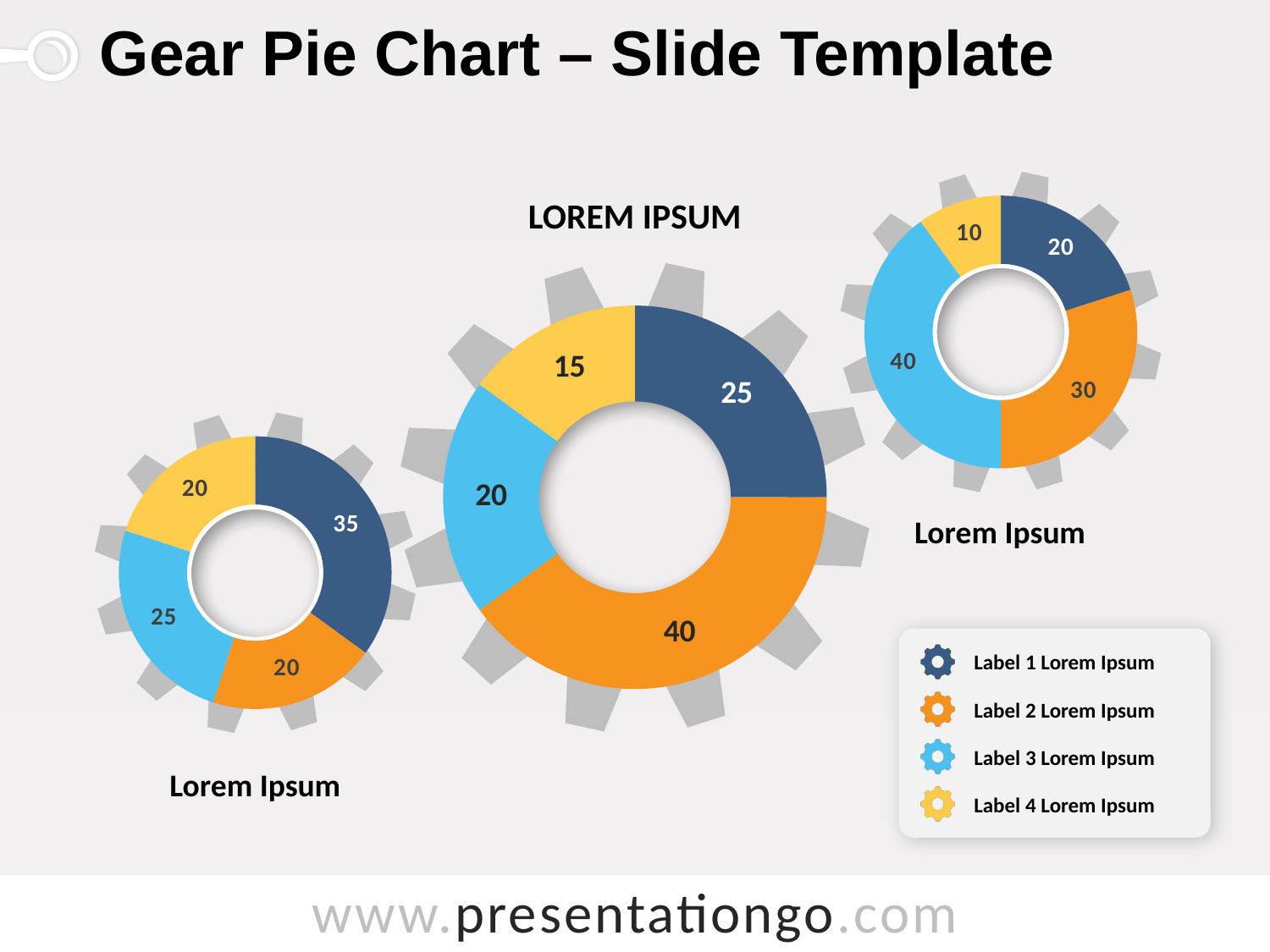
In the center chart titled LOREM IPSUM, what is the value of the yellow slice (Label 4 Lorem Ipsum)? 15 In the center chart titled LOREM IPSUM, what share of the total (25+40+20+15=100) does the orange slice represent? 40% What kind of chart is the center chart titled LOREM IPSUM? Pie chart (donut) In the right chart, which label has the smallest slice? Label 4 Lorem Ipsum In the center chart titled LOREM IPSUM, which label has the largest slice? Label 2 Lorem Ipsum How many entries does the legend on the slide list? 4 In the right chart, which is larger: the orange slice (Label 2) or the dark blue slice (Label 1)? The orange slice (Label 2) In the left chart, what is the value of the dark blue slice (Label 1 Lorem Ipsum)? 35 In the left chart, what is the difference between the dark blue slice (35) and the light blue slice (25)? 10 How many slices does the center chart titled LOREM IPSUM have? 4 In the center chart titled LOREM IPSUM, what is the value of the orange slice (Label 2 Lorem Ipsum)? 40 In the right chart, what is the value of the light blue slice (Label 3 Lorem Ipsum)? 40